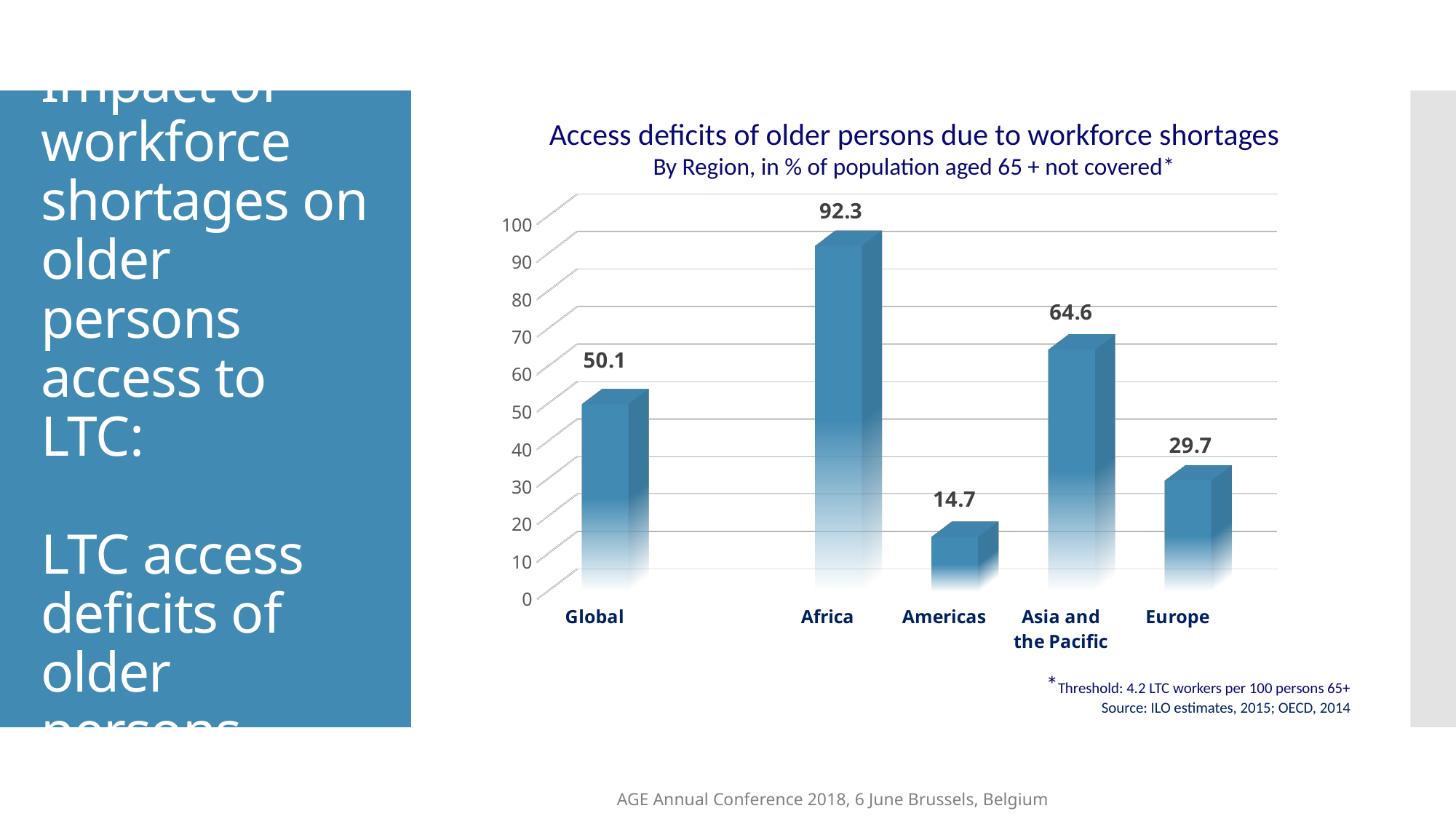
How many categories are shown on the x axis? 5 What is the value for Europe? 29.7 Which region has the lowest access deficit? Americas What is the difference between the values for Africa and Europe? 62.6 What is the value for Africa? 92.3 Which region has the highest access deficit? Africa What kind of chart is shown on the slide? bar chart Is the value for Europe greater or less than 40? less What is the title of the chart? Access deficits of older persons due to workforce shortages Which is larger, the value for Asia and the Pacific or the value for Global? Asia and the Pacific What is the value for Global? 50.1 What is the difference between the values for Asia and the Pacific and the Americas? 49.9